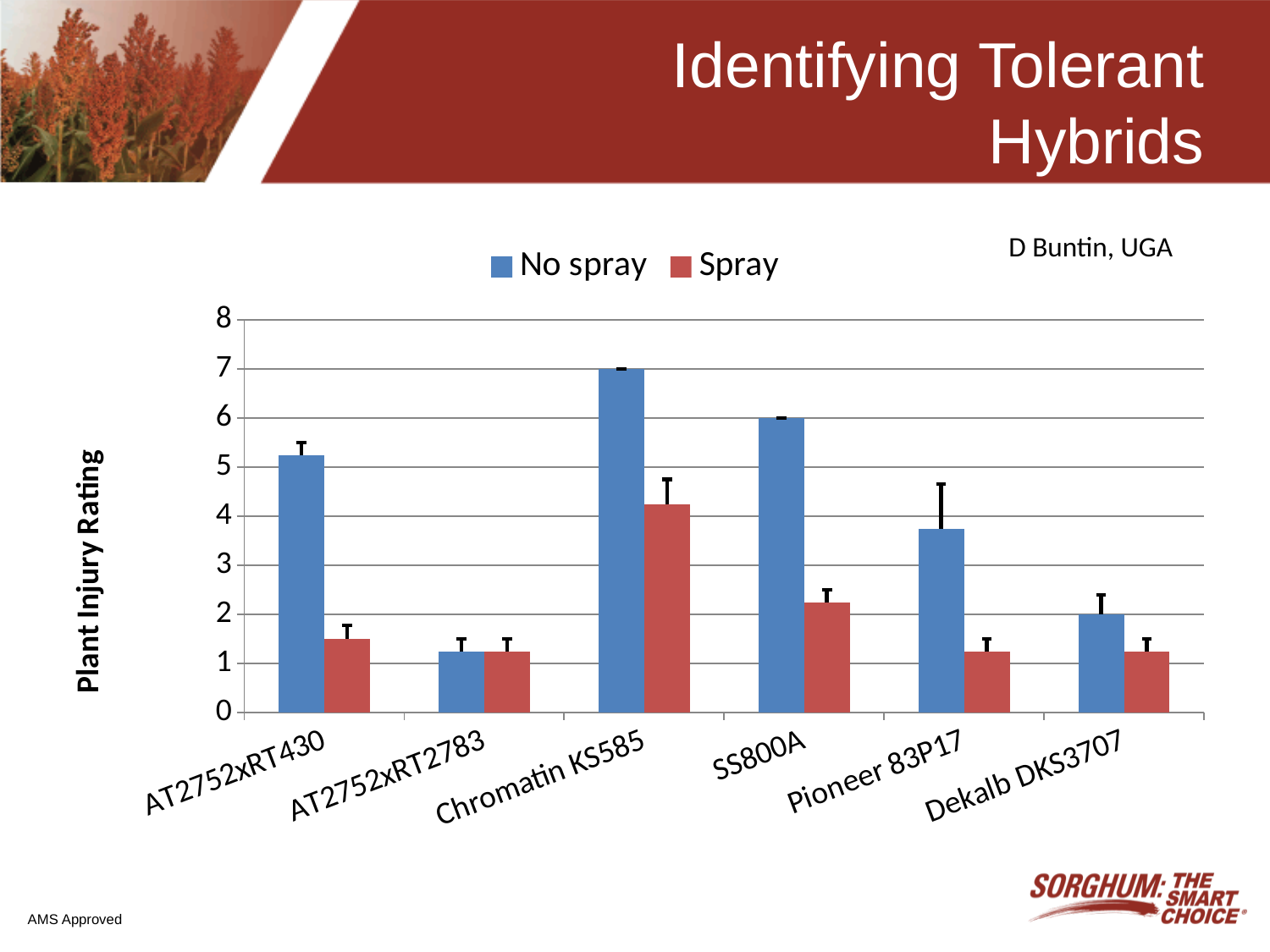
What kind of chart is shown on the slide? bar chart Is the No spray value for AT2752xRT430 greater or less than 5? greater Which hybrid has the highest No spray plant injury rating? Chromatin KS585 What is the No spray plant injury rating for SS800A? 6 Which hybrid has the lowest No spray plant injury rating? AT2752xRT2783 What is the difference between the No spray ratings for Chromatin KS585 and SS800A? 1 What is the No spray plant injury rating for Chromatin KS585? 7 For AT2752xRT430, which is larger, the No spray rating or the Spray rating? No spray What is the title of the vertical axis? Plant Injury Rating How many hybrids are shown along the x axis? 6 How many series does the legend list? 2 What is the No spray plant injury rating for Dekalb DKS3707? 2